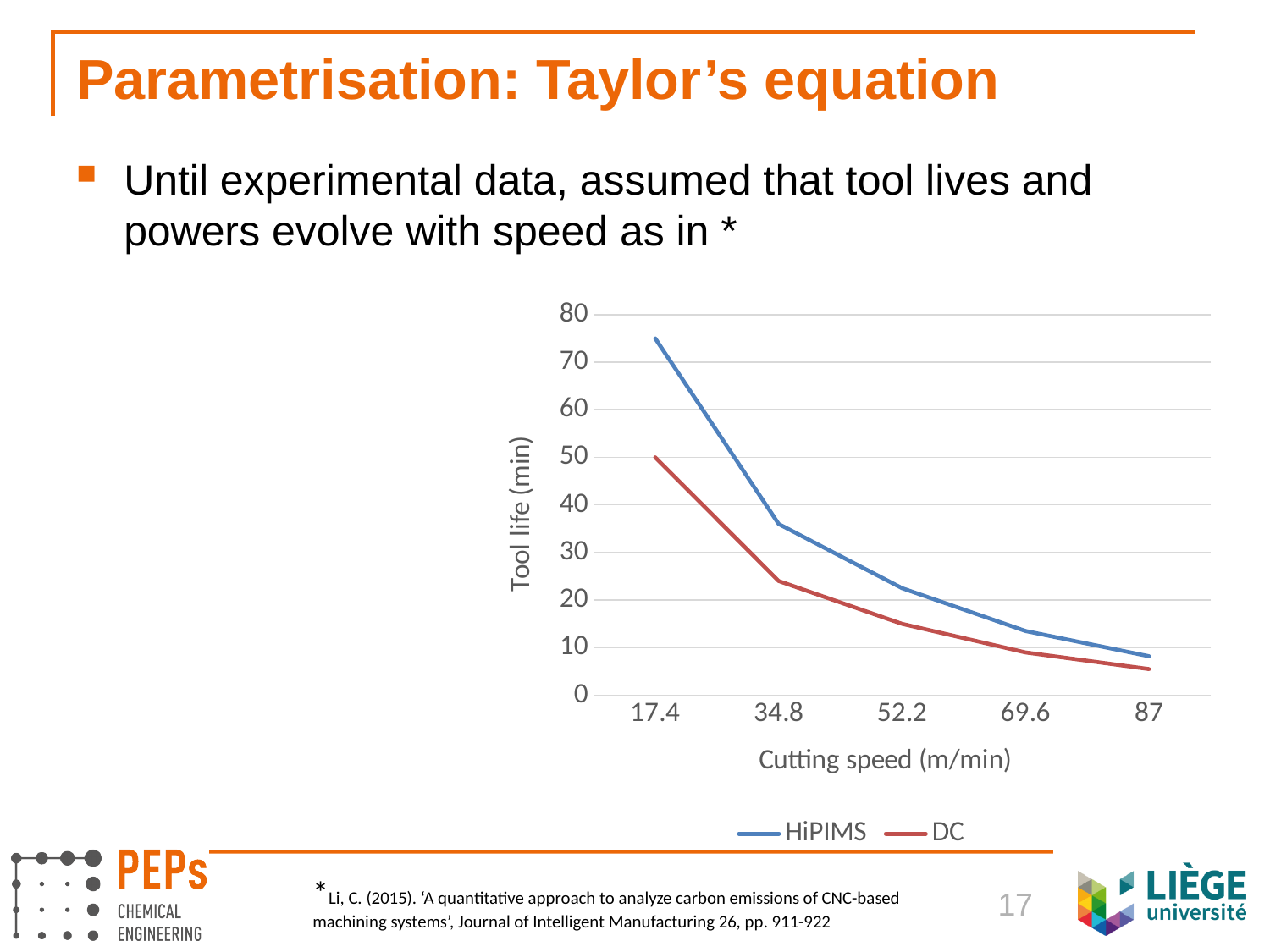
At a cutting speed of 17.4 m/min, which series has the larger tool life, HiPIMS or DC? HiPIMS What is the label of the y axis? Tool life (min) How many cutting speed values are plotted along the x axis? 5 Does tool life rise or fall as cutting speed increases? fall Is the DC tool life at a cutting speed of 17.4 greater or less than 60? less What kind of chart is shown on the slide? line chart Is the HiPIMS tool life at a cutting speed of 17.4 greater or less than 70? greater How many series does the legend list? 2 At which cutting speed is the DC tool life lowest? 87 Is the HiPIMS tool life at a cutting speed of 87 greater or less than 10? less At which cutting speed is the HiPIMS tool life highest? 17.4